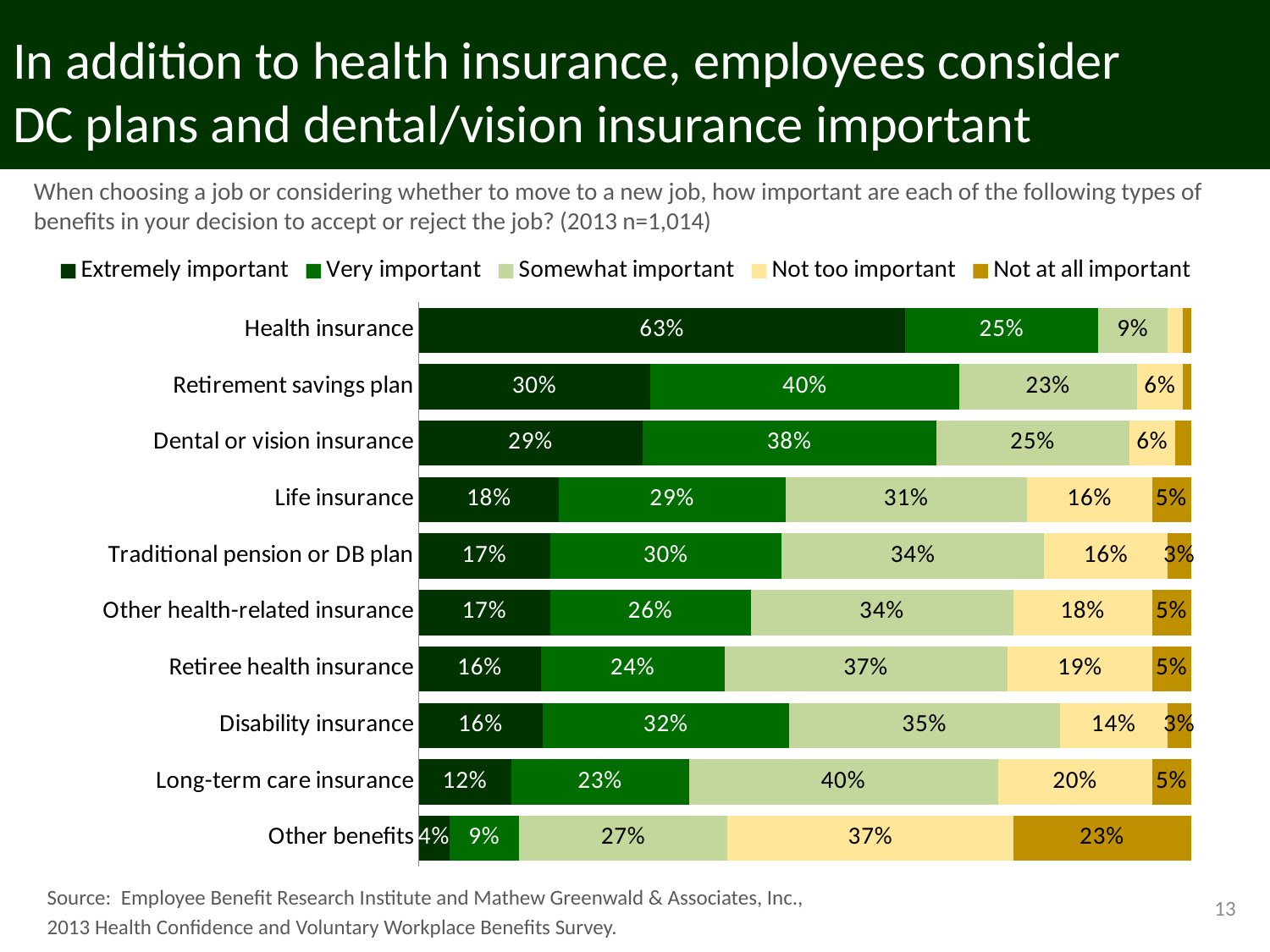
What is the first entry in the chart's legend? Extremely important What is the 'Not at all important' value for Other benefits? 23% How many benefit types are shown in the chart? 10 Which benefit has the lowest 'Extremely important' percentage? Other benefits What percentage of employees rated health insurance as extremely important? 63% What is the total of the stacked bar for Other benefits? 100% Which benefit has the highest 'Extremely important' percentage? Health insurance What is the difference in 'Extremely important' percentage between Health insurance and Retirement savings plan? 33 percentage points How many importance levels does the legend list? 5 What type of chart is shown on the slide? Stacked bar chart What is the 'Very important' value for Retirement savings plan? 40% Which has a larger 'Somewhat important' value: Long-term care insurance or Retiree health insurance? Long-term care insurance